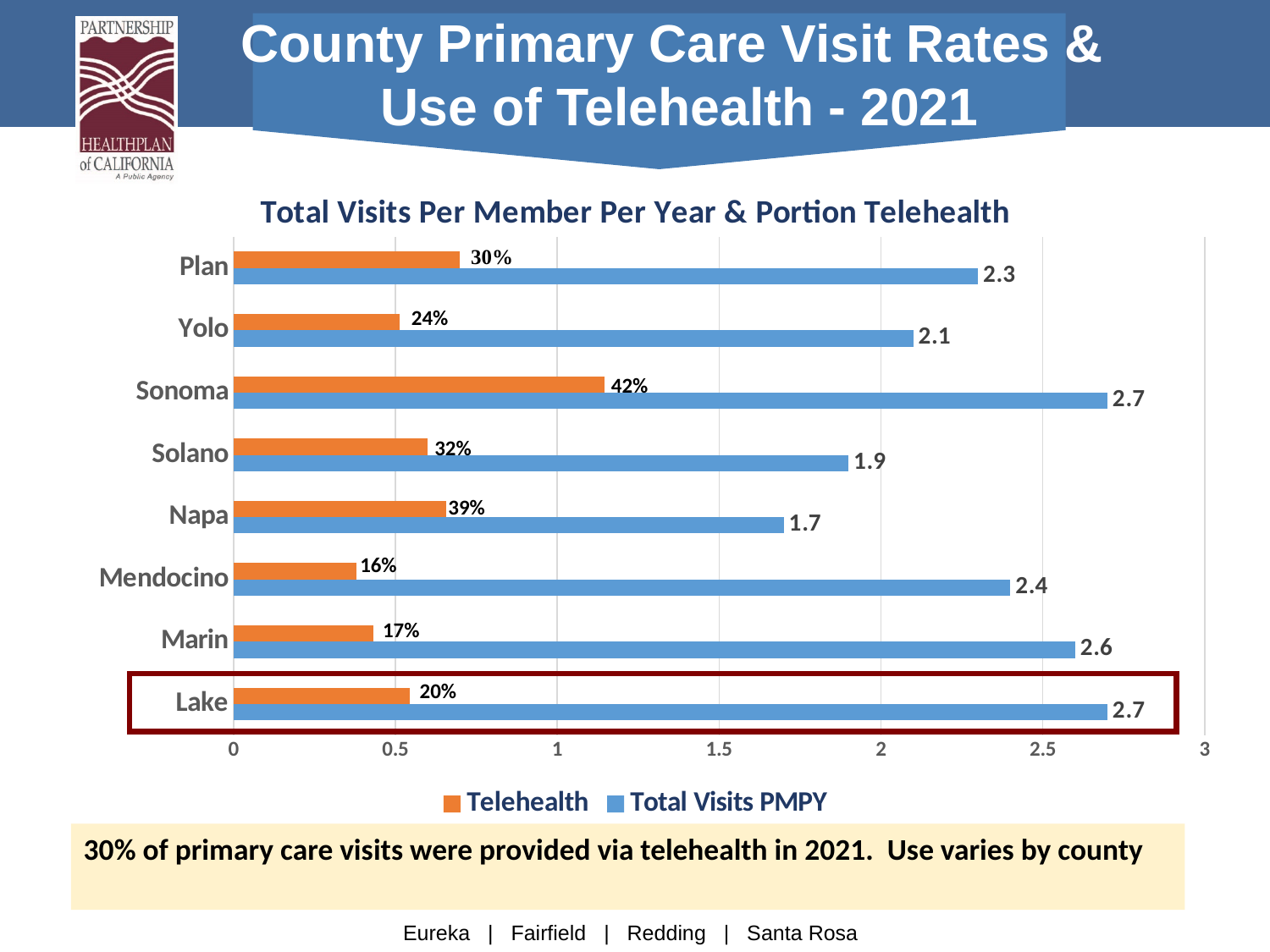
What is the difference between the Total Visits PMPY values for Marin and Yolo? 0.5 How many series does the legend list? 2 Is the Total Visits PMPY value for Mendocino greater or less than 2? greater What is the Total Visits PMPY value for Plan? 2.3 Which category has the highest Telehealth percentage? Sonoma Which has a larger Total Visits PMPY value, Solano or Napa? Solano What is the Telehealth percentage shown for Napa? 39% What type of chart is shown on the slide? Bar chart How many categories are shown on the chart? 8 Which category has the lowest Telehealth percentage? Mendocino What is the Total Visits PMPY value for Mendocino? 2.4 Which category has the lowest Total Visits PMPY value? Napa